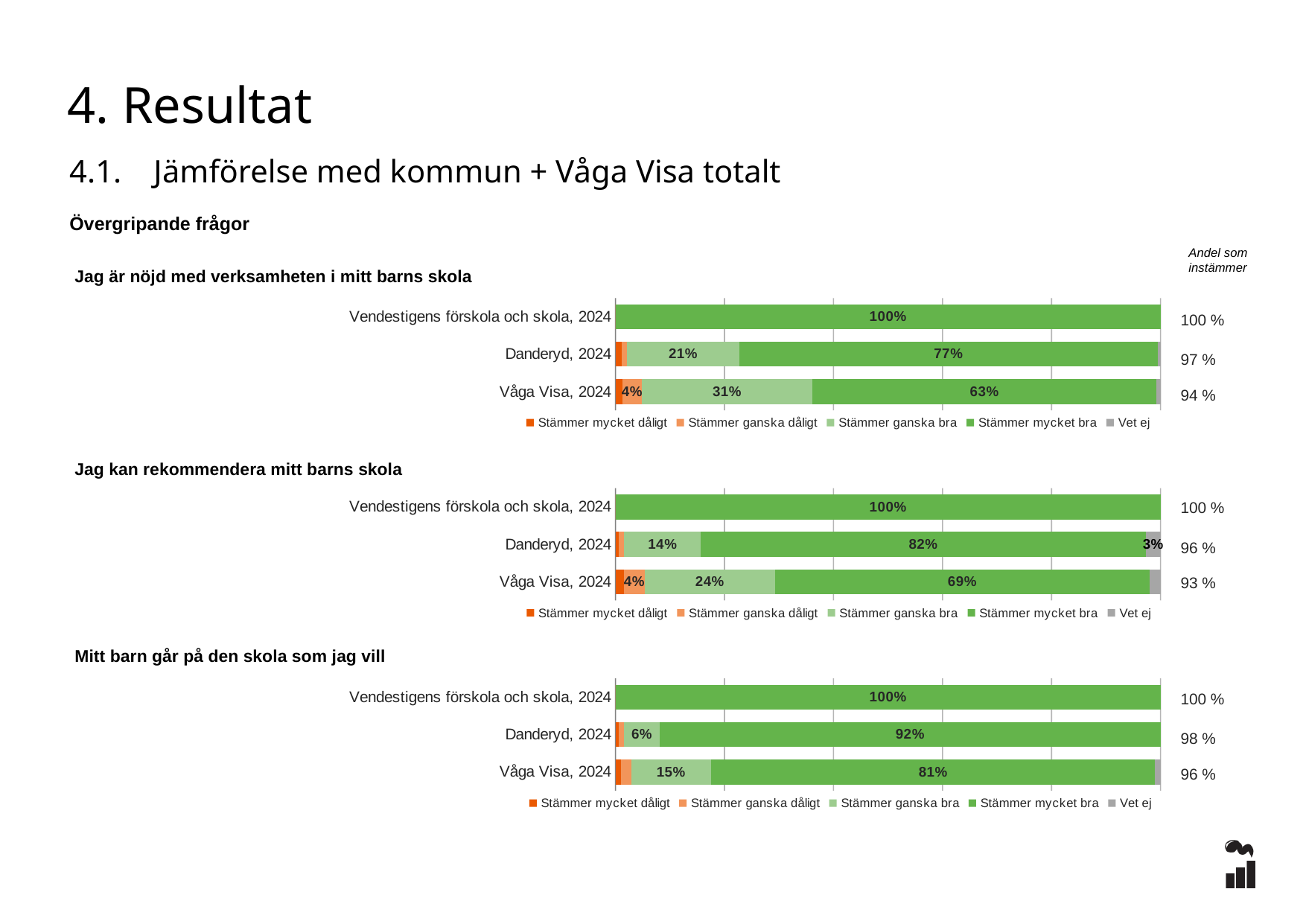
In the chart 'Jag kan rekommendera mitt barns skola', what is the 'Stämmer mycket bra' value for Danderyd, 2024? 82% In the chart 'Jag är nöjd med verksamheten i mitt barns skola', what is the 'Stämmer ganska bra' value for Våga Visa, 2024? 31% In the chart 'Mitt barn går på den skola som jag vill', which row has the highest 'Stämmer mycket bra' value? Vendestigens förskola och skola, 2024 How many rows (categories) does the chart 'Jag kan rekommendera mitt barns skola' show? 3 In the chart 'Jag kan rekommendera mitt barns skola', what is the difference between the 'Stämmer mycket bra' values for Danderyd, 2024 and Våga Visa, 2024? 13% How many series does the legend of the chart 'Jag är nöjd med verksamheten i mitt barns skola' list? 5 What kind of chart is 'Mitt barn går på den skola som jag vill'? Stacked bar chart In the chart 'Jag är nöjd med verksamheten i mitt barns skola', what is the 'Stämmer mycket bra' value for Danderyd, 2024? 77% In the chart 'Mitt barn går på den skola som jag vill', is the 'Stämmer mycket bra' value larger for Danderyd, 2024 or Våga Visa, 2024? Danderyd, 2024 In the chart 'Mitt barn går på den skola som jag vill', what is the 'Stämmer ganska bra' value for Våga Visa, 2024? 15% In the chart 'Jag är nöjd med verksamheten i mitt barns skola', which row has the lowest 'Stämmer mycket bra' value? Våga Visa, 2024 In the chart 'Jag kan rekommendera mitt barns skola', what is the 'Vet ej' value for Danderyd, 2024? 3%